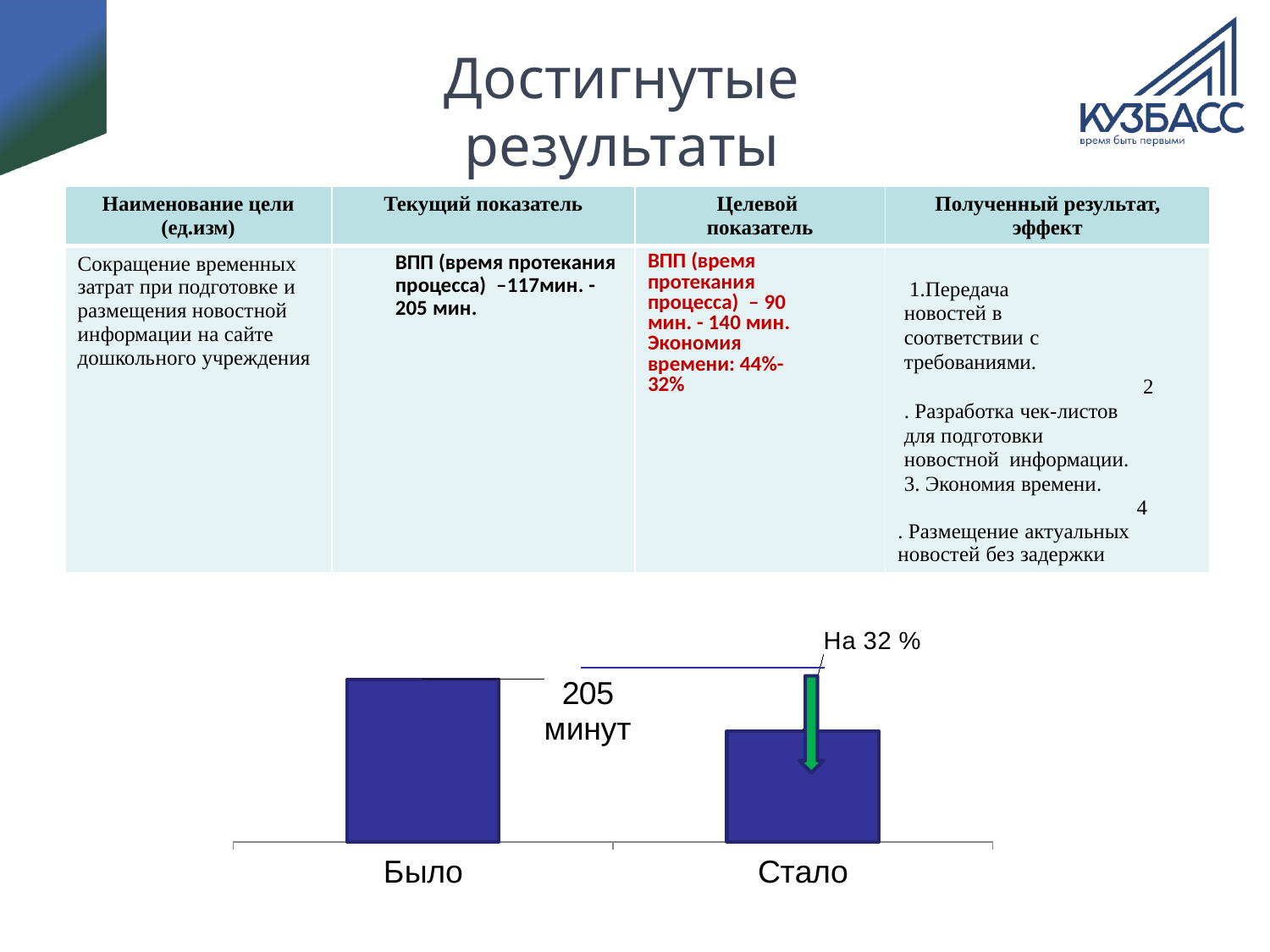
Which bar is taller, "Было" or "Стало"? Было Which bar is the shortest in the chart? Стало Which bar is the tallest in the chart? Было What value is labelled for the "Было" bar? 205 минут Do the bar values rise or fall from "Было" to "Стало"? fall What are the two category labels on the x axis of the chart? Было, Стало What percentage reduction is annotated next to the arrow above the "Стало" bar? На 32 % What kind of chart is shown at the bottom of the slide? bar chart How many bars does the chart show? 2